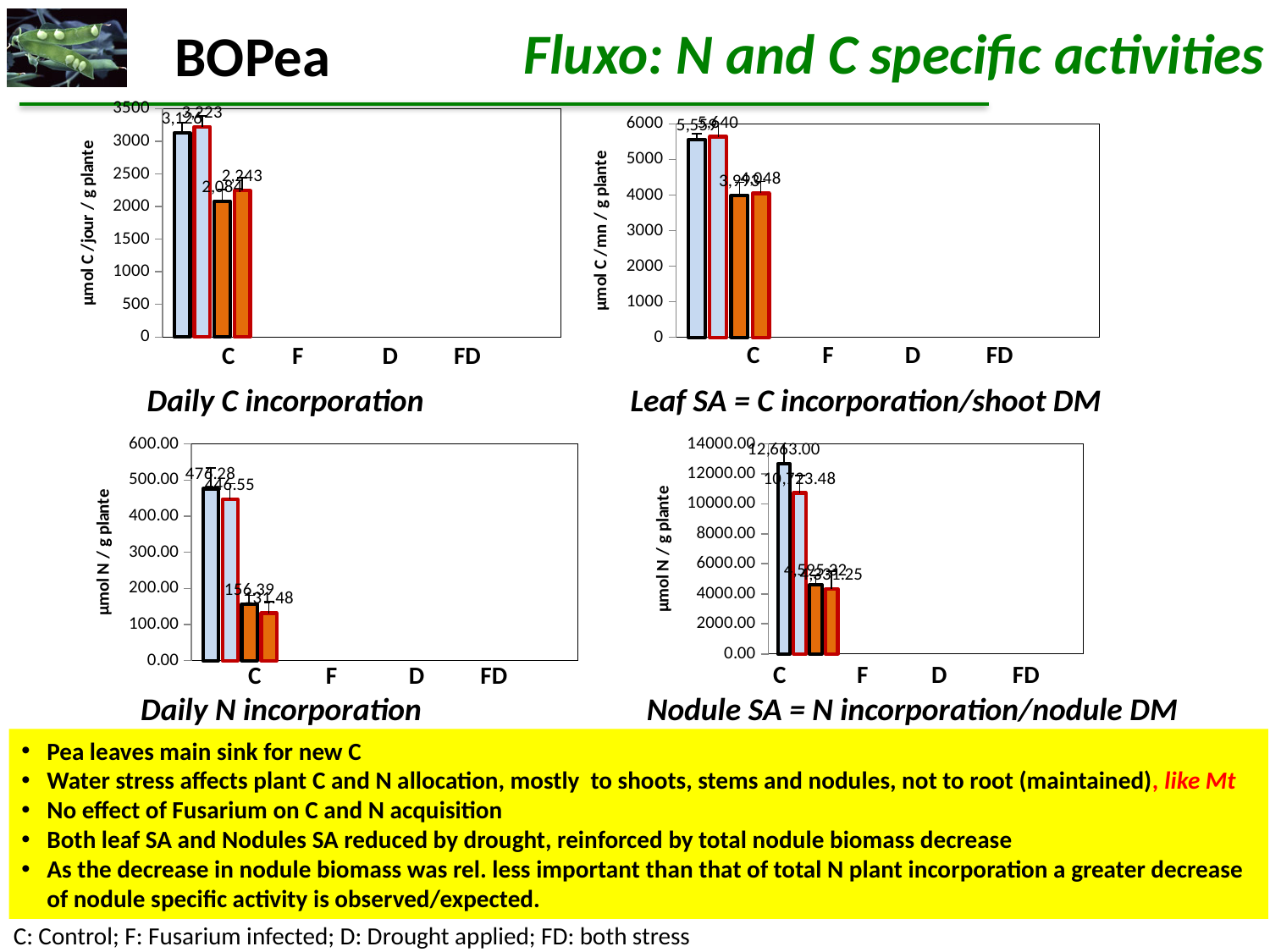
In the 'Daily N incorporation' chart, is the value of the third bar from the left greater or less than 200.00? less In the 'Daily N incorporation' chart, which is larger: the first bar or the third bar from the left? the first bar In the 'Nodule SA = N incorporation/nodule DM' chart, is the value of the tallest bar greater or less than 12000.00? greater In the 'Daily C incorporation' chart, is the value of the tallest bar greater or less than 3000? greater What kind of chart is the 'Daily C incorporation' chart? bar chart In the 'Daily N incorporation' chart, do the bar values rise or fall from left to right? fall What is the y-axis title of the 'Leaf SA = C incorporation/shoot DM' chart? µmol C /mn / g plante How many categories are labelled on the x axis of the 'Daily N incorporation' chart? 4